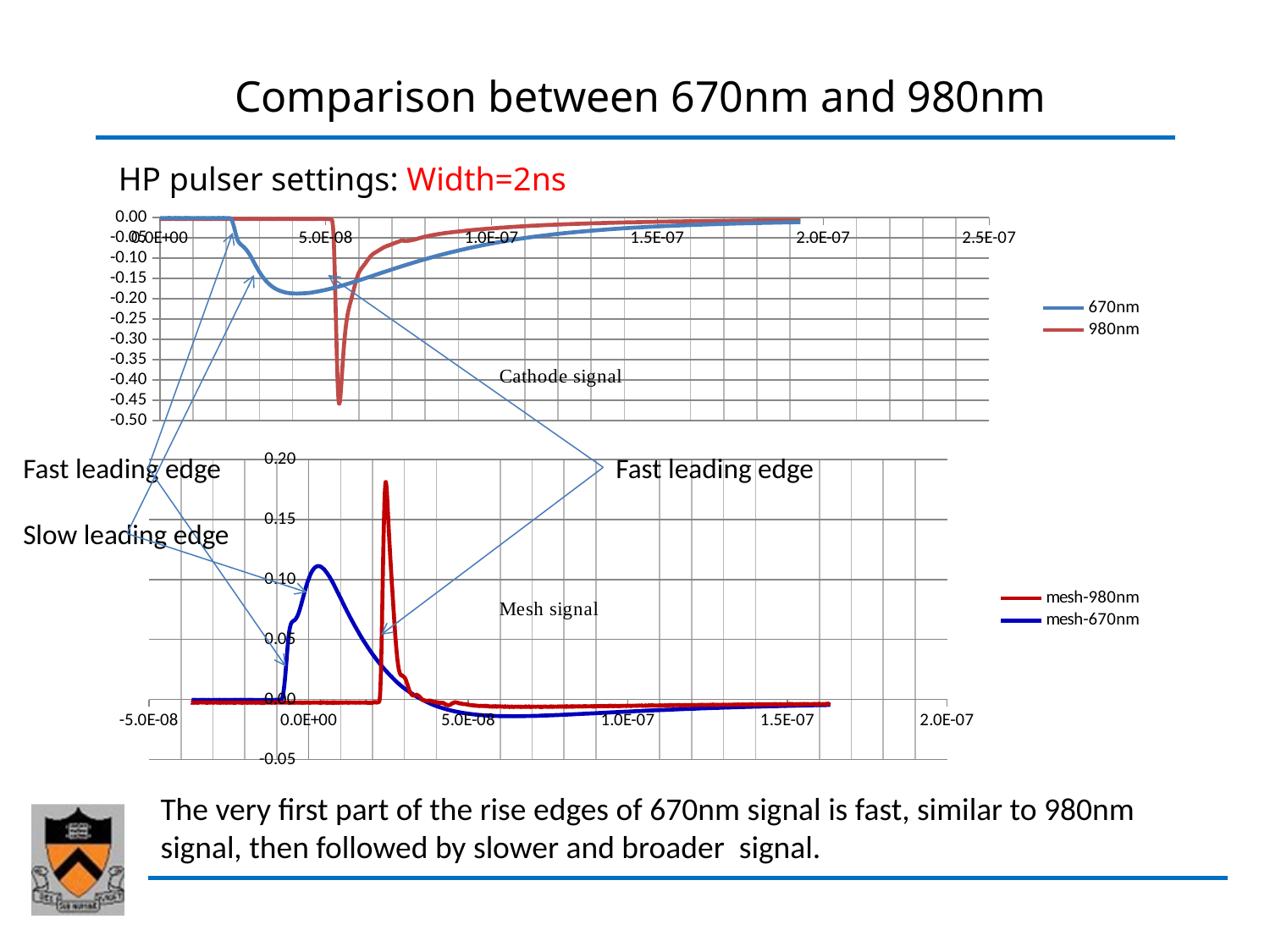
In the "Cathode signal" chart, is the minimum value of the 670nm series greater or less than -0.25? greater In the "Cathode signal" chart, is the minimum value of the 980nm series greater or less than -0.40? less In the "Mesh signal" chart, which series reaches the highest peak value? mesh-980nm In the "Mesh signal" chart, which series is drawn in red? mesh-980nm How many series does the legend of the "Mesh signal" chart list? 2 In the "Mesh signal" chart, is the peak value of the mesh-670nm series greater or less than 0.15? less What are the two legend entries of the "Cathode signal" chart? 670nm and 980nm What kind of chart is the "Mesh signal" chart? line chart How many series does the legend of the "Cathode signal" chart list? 2 What kind of chart is the "Cathode signal" chart? line chart In the "Cathode signal" chart, which series reaches the lowest (most negative) value? 980nm